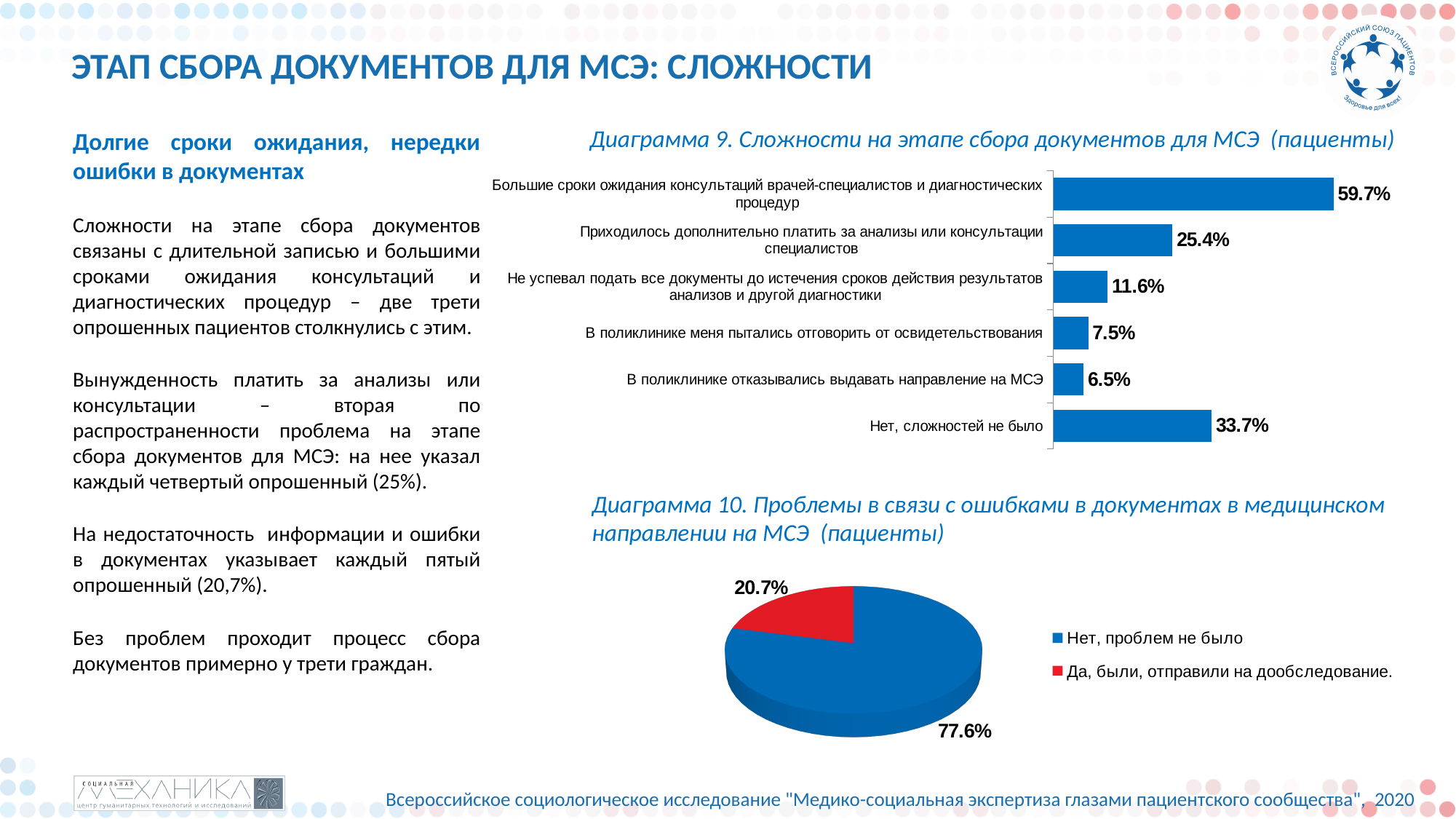
What type of chart is Диаграмма 9? Bar chart In Диаграмма 9, which category has the highest value? Большие сроки ожидания консультаций врачей-специалистов и диагностических процедур In Диаграмма 9, what is the value for «Большие сроки ожидания консультаций врачей-специалистов и диагностических процедур»? 59.7% In Диаграмма 9, which is larger: «Не успевал подать все документы до истечения сроков действия результатов анализов и другой диагностики» or «В поликлинике меня пытались отговорить от освидетельствования»? Не успевал подать все документы до истечения сроков действия результатов анализов и другой диагностики In Диаграмма 9, what is the value for «Приходилось дополнительно платить за анализы или консультации специалистов»? 25.4% In Диаграмма 9, which category has the lowest value? В поликлинике отказывались выдавать направление на МСЭ How many entries does the legend of Диаграмма 10 list? 2 In Диаграмма 10, what share of the pie is «Да, были, отправили на дообследование.»? 20.7% In Диаграмма 9, what is the value for «В поликлинике отказывались выдавать направление на МСЭ»? 6.5% How many categories are shown in Диаграмма 9? 6 In Диаграмма 10, what is the value for «Нет, проблем не было»? 77.6% In Диаграмма 9, what is the difference between «Нет, сложностей не было» and «Приходилось дополнительно платить за анализы или консультации специалистов»? 8.3%